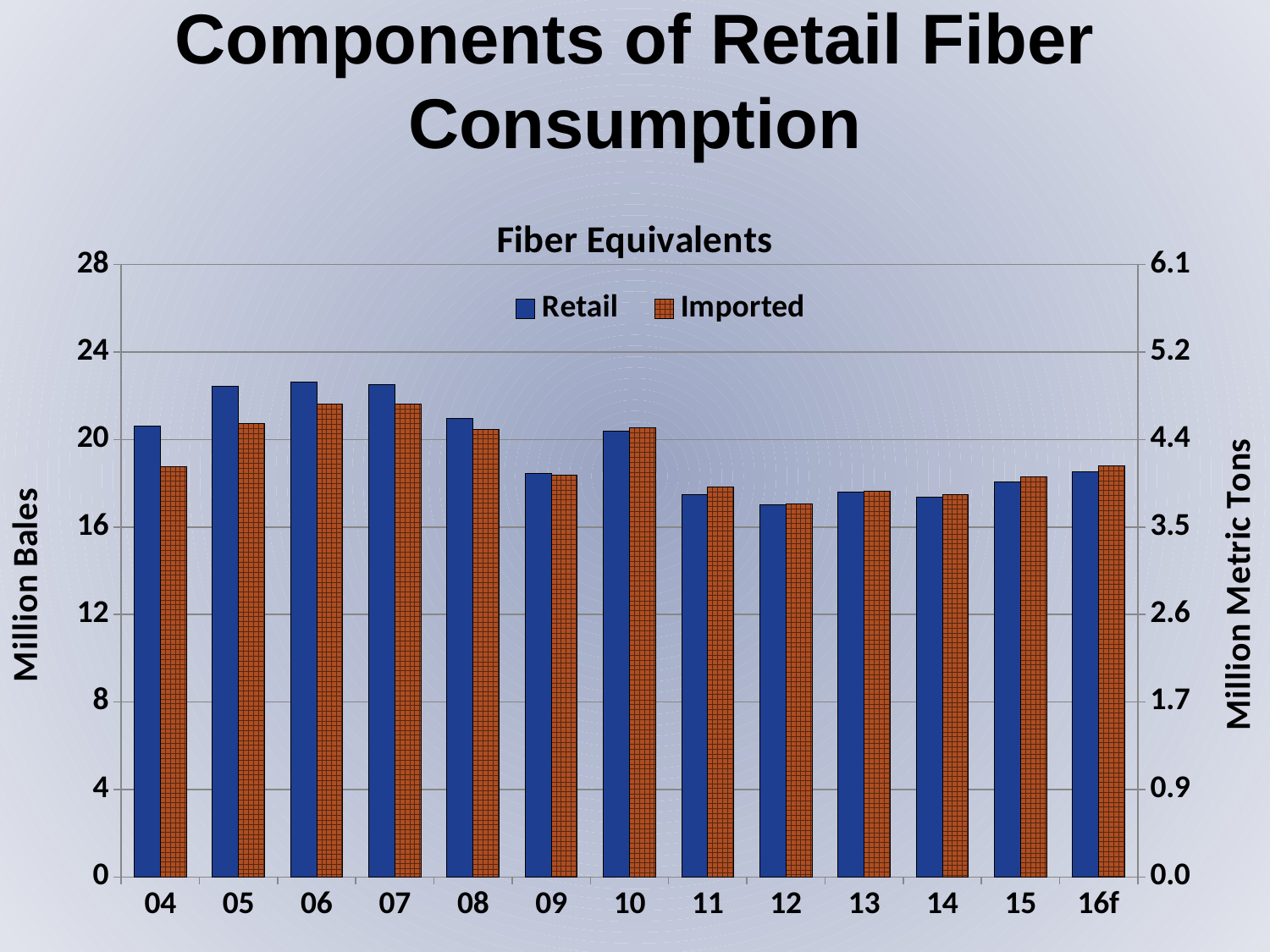
For 04, which is larger, Retail or Imported? Retail Is the Retail value for 05 greater or less than 20 million bales? greater Which is larger, the Retail value for 06 or the Retail value for 12? 06 Is the Retail value for 12 greater or less than 16 million bales? greater Is the Retail value for 09 greater or less than 20 million bales? less What is the title of the chart? Fiber Equivalents What is the label of the right-hand vertical axis? Million Metric Tons How many series does the legend list? 2 What kind of chart is shown on the slide? bar chart How many year categories are shown on the x axis? 13 Between 07 and 12, do the Retail values rise or fall? fall